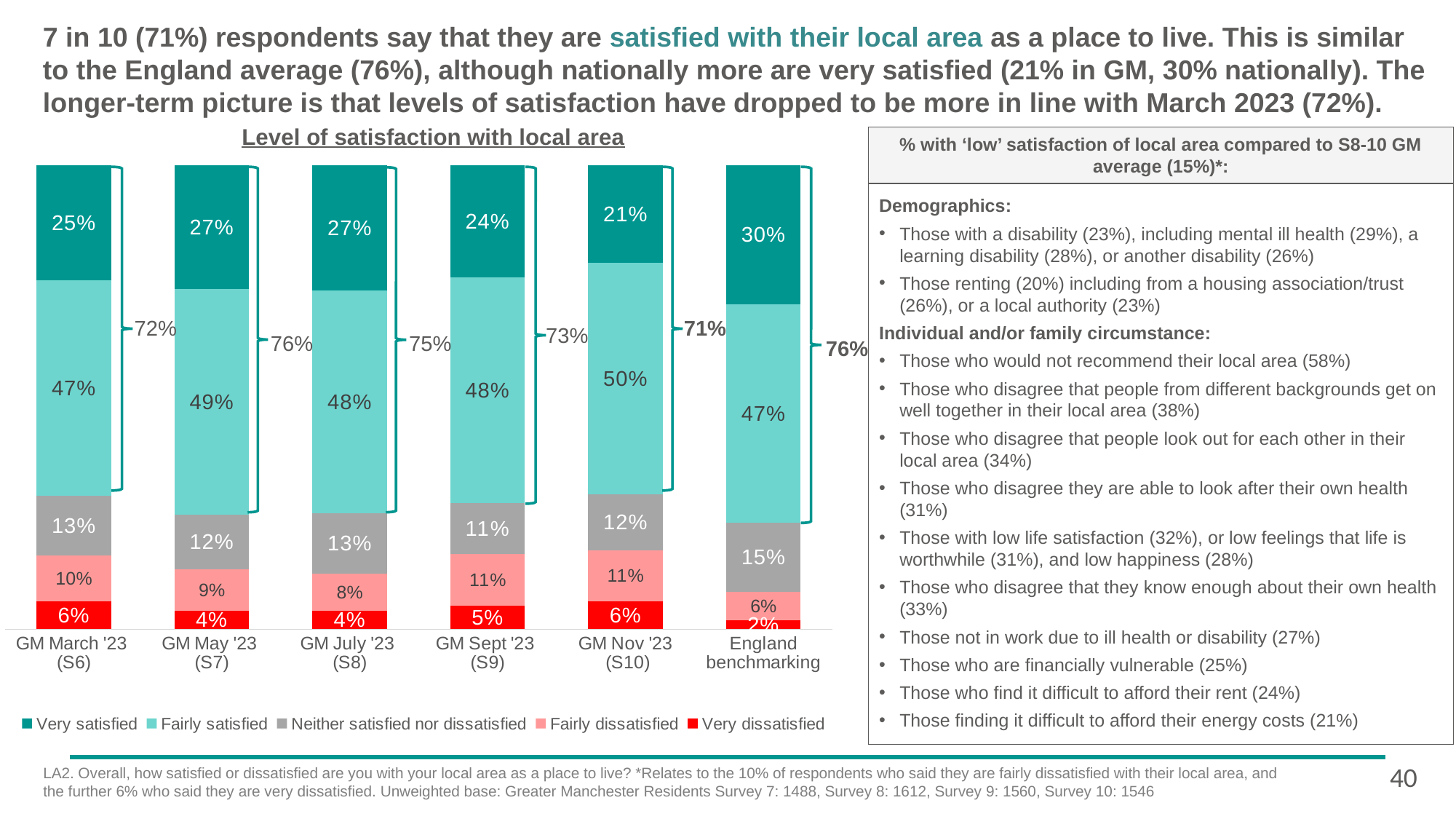
Does the very satisfied share rise or fall from GM July '23 (S8) to GM Nov '23 (S10)? Fall How many bars (survey waves/benchmarks) are shown in the chart? 6 What percentage of respondents were very satisfied in GM Nov '23 (S10)? 21% How many series does the legend list? 5 Which has a larger fairly dissatisfied share, GM March '23 (S6) or GM July '23 (S8)? GM March '23 (S6) What type of chart is used to show the level of satisfaction with local area? Stacked bar chart What percentage of respondents were fairly satisfied in the England benchmarking bar? 47% What is the combined very satisfied and fairly satisfied share for GM March '23 (S6)? 72% Which bar has the lowest percentage of very dissatisfied respondents? England benchmarking Which bar has the highest percentage of very satisfied respondents? England benchmarking What percentage of respondents were very dissatisfied in GM May '23 (S7)? 4% How many percentage points higher is the very satisfied share for England benchmarking than for GM Nov '23 (S10)? 9 percentage points